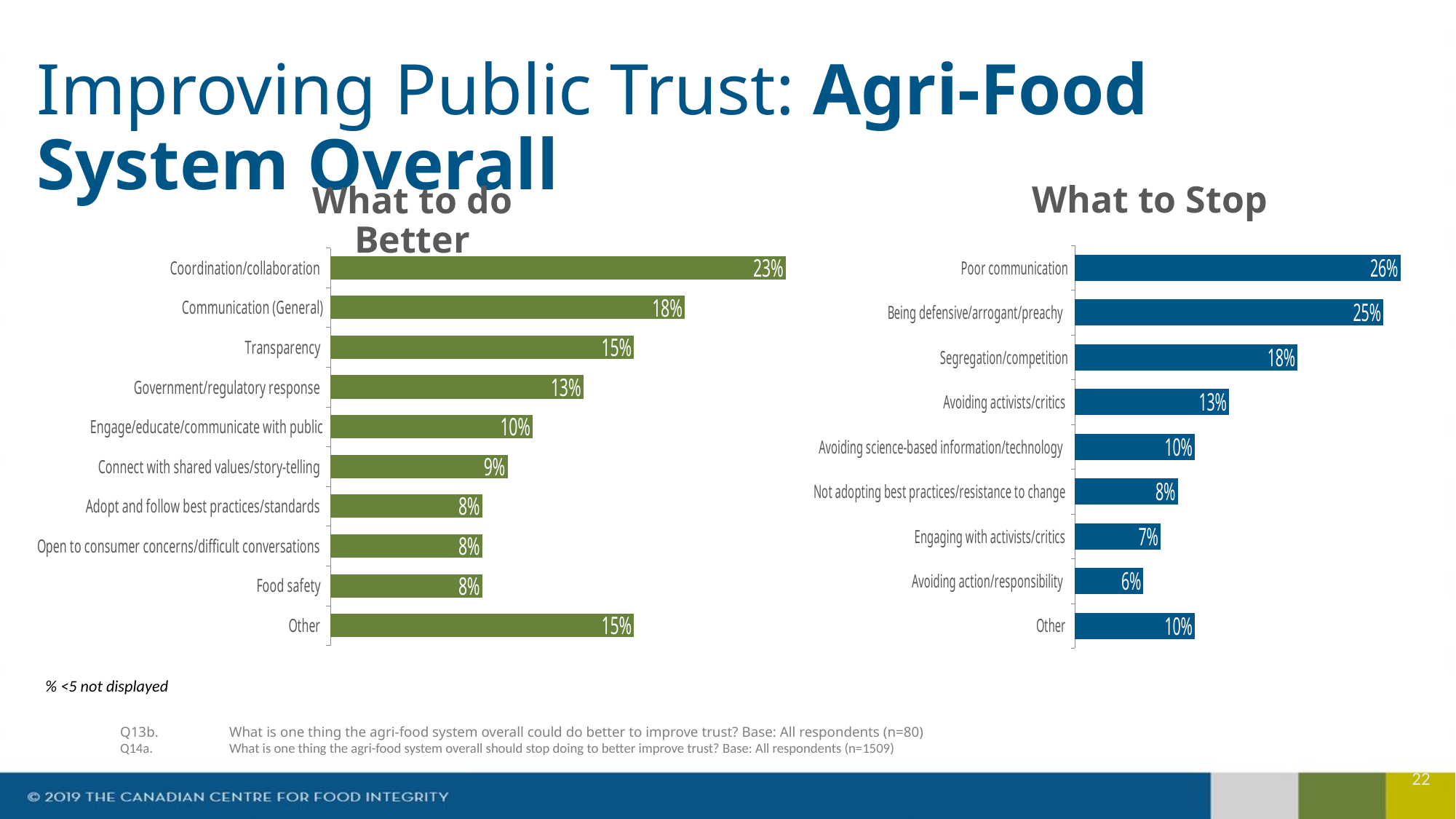
In the 'What to Stop' chart, which category has the lowest value? Avoiding action/responsibility How many categories are shown in the 'What to Stop' chart? 9 In the 'What to Stop' chart, what is the value for Other? 10% In the 'What to do Better' chart, what is the value for Transparency? 15% What kind of chart is the 'What to Stop' chart? Bar chart In the 'What to Stop' chart, what is the value for Segregation/competition? 18% In the 'What to Stop' chart, which is larger: Engaging with activists/critics or Not adopting best practices/resistance to change? Not adopting best practices/resistance to change In the 'What to Stop' chart, what is the difference between Poor communication and Avoiding activists/critics? 13% In the 'What to do Better' chart, which is larger: Government/regulatory response or Connect with shared values/story-telling? Government/regulatory response In the 'What to do Better' chart, which category has the highest value? Coordination/collaboration In the 'What to do Better' chart, what is the difference between Communication (General) and Engage/educate/communicate with public? 8% How many categories are shown in the 'What to do Better' chart? 10